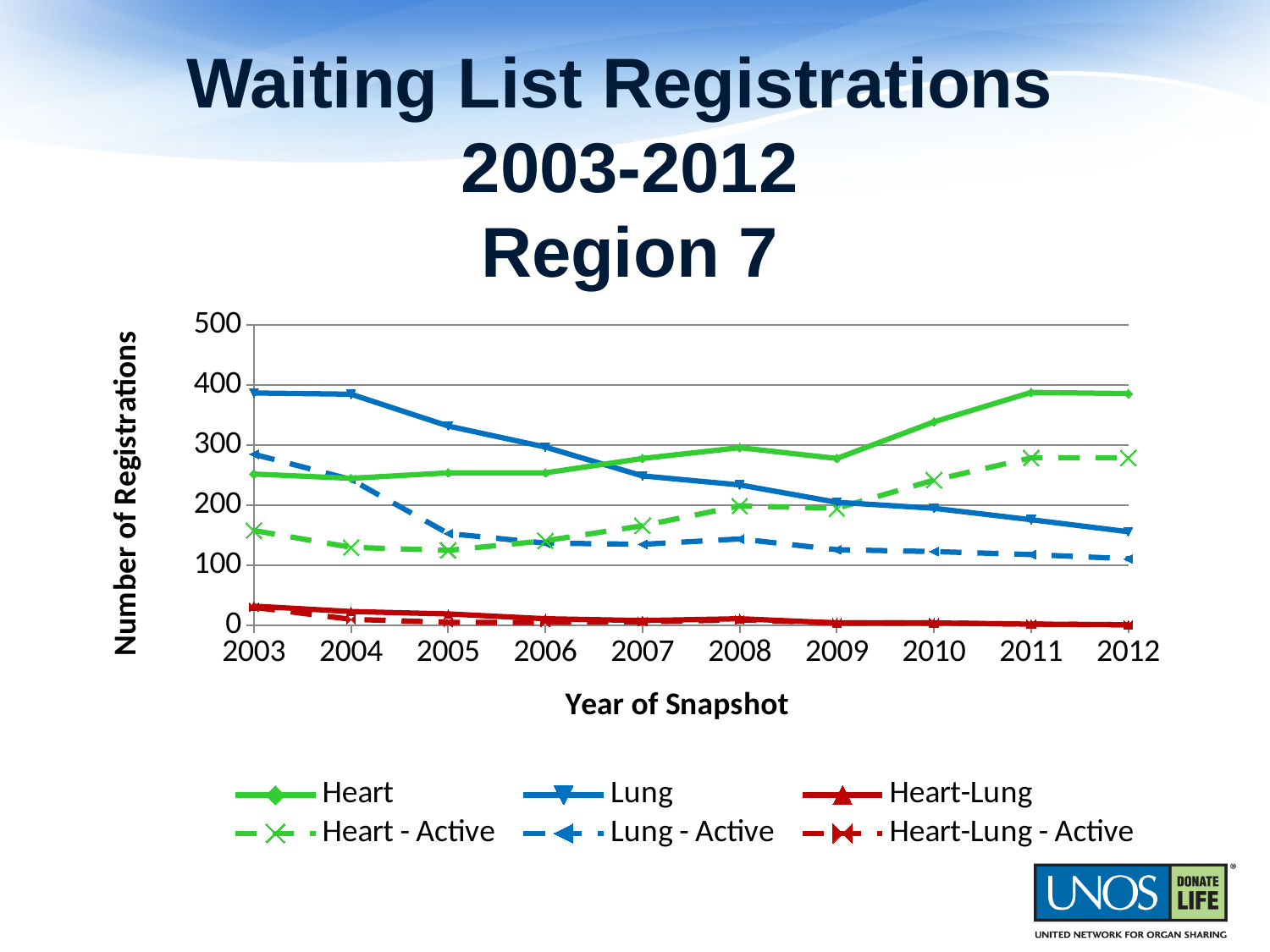
Do the values for the Heart series rise or fall overall from 2003 to 2012? rise How many years are plotted along the x axis? 10 Is the value for Heart in 2011 greater or less than 300? greater Do the values for the Lung series rise or fall from 2003 to 2012? fall In 2003, which series has the larger value, Heart or Lung? Lung In 2012, which series has the larger value, Heart or Lung? Heart How many series does the legend list? 6 Is the value for Heart-Lung in 2003 greater or less than 100? less What is the title of the y axis? Number of Registrations Is the value for Lung in 2012 greater or less than 200? less What kind of chart is shown on the slide? line chart